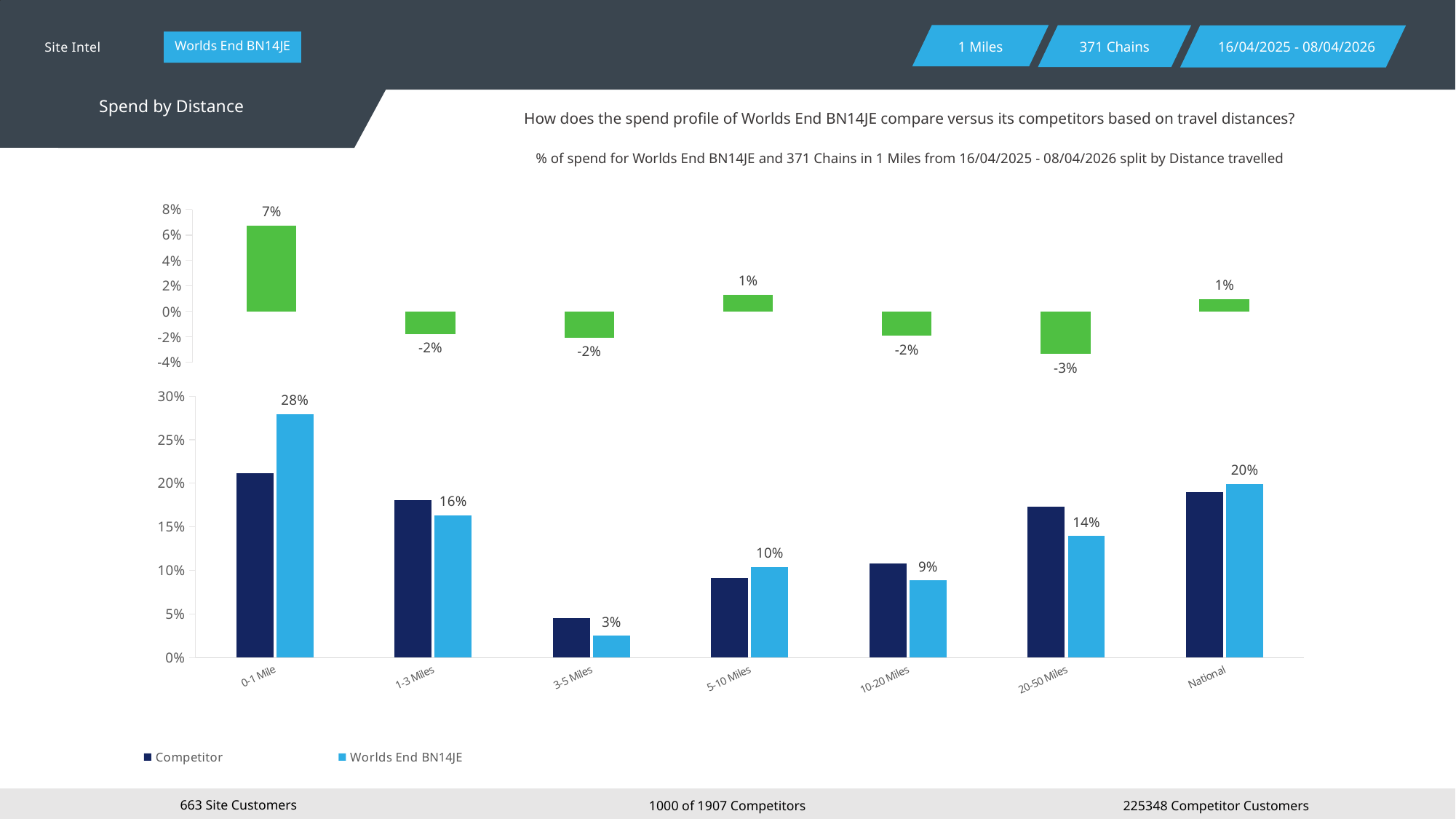
In the top chart, what is the value for the 0-1 Mile category? 7% How many categories are shown on the x axis of the bottom chart? 7 In the bottom chart, which is larger in the 20-50 Miles category, Competitor or Worlds End BN14JE? Competitor In the bottom chart, which category has the highest value for Worlds End BN14JE? 0-1 Mile How many series does the legend of the bottom chart list? 2 In the bottom chart, what is the value for Worlds End BN14JE in the 0-1 Mile category? 28% In the bottom chart, what is the value for Worlds End BN14JE in the 3-5 Miles category? 3% In the bottom chart, what is the difference between the Worlds End BN14JE values for 0-1 Mile and 1-3 Miles? 12% In the top chart, which category has the lowest value? 20-50 Miles In the bottom chart, is the Competitor value for 0-1 Mile greater or less than 20%? greater In the top chart, what is the value for the 20-50 Miles category? -3% In the bottom chart, what is the value for Worlds End BN14JE in the National category? 20%